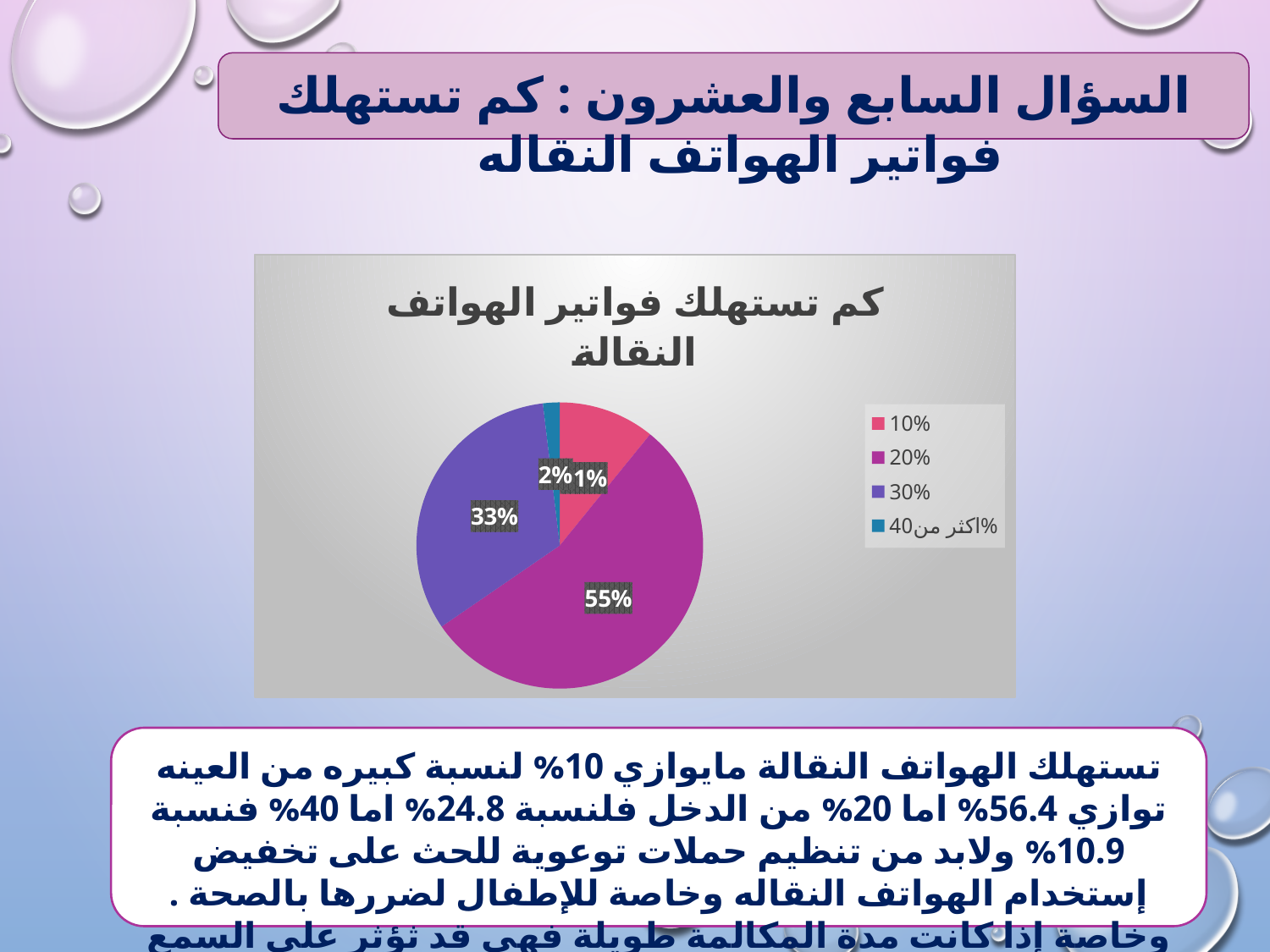
How many slices does the pie chart have? 4 How many entries does the chart legend list? 4 What is the title of the chart? كم تستهلك فواتير الهواتف النقالة What share of the pie does the '20%' category take? 55% What kind of chart is shown on the slide? Pie chart What is the difference between the shares of the '20%' and '30%' categories? 22 percentage points Which slice is larger, '30%' or 'اكثر من 40%'? 30% Which slice is larger, '20%' or '30%'? 20% What are the four legend entries of the chart? 10%, 20%, 30%, اكثر من 40% Which category has the largest slice of the pie? 20% What share of the pie does the '30%' category take? 33% What share of the pie does the 'اكثر من 40%' category take? 2%